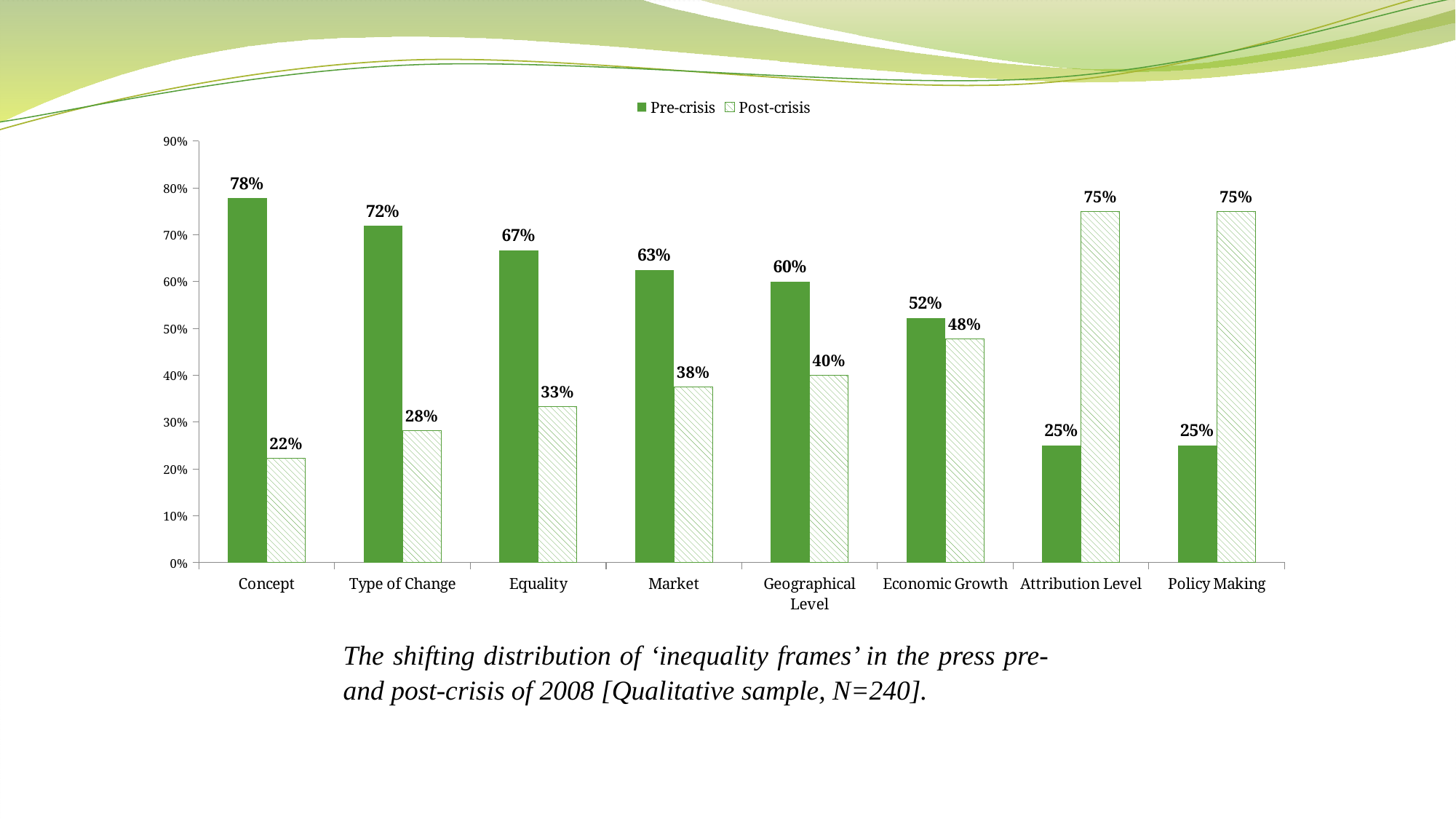
Is the Pre-crisis value for Geographical Level greater or less than 50%? greater What is the Post-crisis value for Economic Growth? 48% Which category has the lowest Post-crisis value? Concept What is the Post-crisis value for Market? 38% Which is larger for Attribution Level, the Pre-crisis or the Post-crisis value? Post-crisis What is the difference between the Pre-crisis and Post-crisis values for Equality? 34% What is the Pre-crisis value for Concept? 78% How many categories are shown on the x axis? 8 Which series is drawn with a hatched pattern in the legend? Post-crisis What kind of chart is shown on the slide? Bar chart Which category has the highest Pre-crisis value? Concept How many series does the legend list? 2